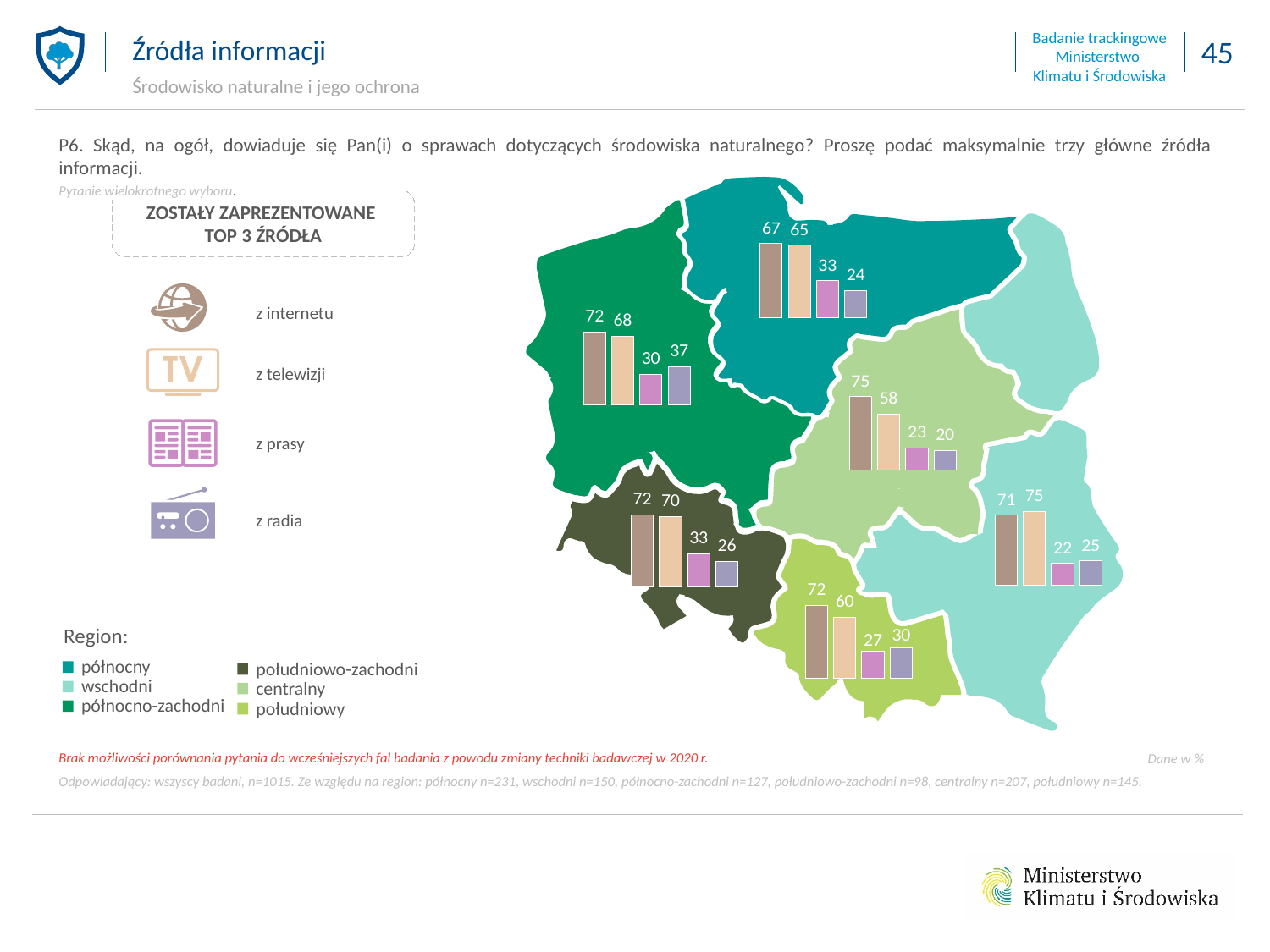
In the południowy region, what is the value for the press (z prasy)? 27 How many information sources are shown as bars for each region? 4 In the północno-zachodni region, what is the value for radio (z radia)? 37 How many regions are shown on the map with their own bar charts? 6 Which region has the lowest value for television (z telewizji)? centralny In the centralny region, what is the difference between the internet value and the television value? 17 In the wschodni region, what is the value for television (z telewizji)? 75 What type of chart is used to show the values within each region on the map? bar chart In the północny region, what percentage of respondents named the internet (z internetu) as a source of information? 67 Which region has the highest value for the internet (z internetu)? centralny In the centralny region, what is the value for radio (z radia)? 20 In the południowo-zachodni region, which is larger: the value for the press (z prasy) or the value for radio (z radia)? z prasy